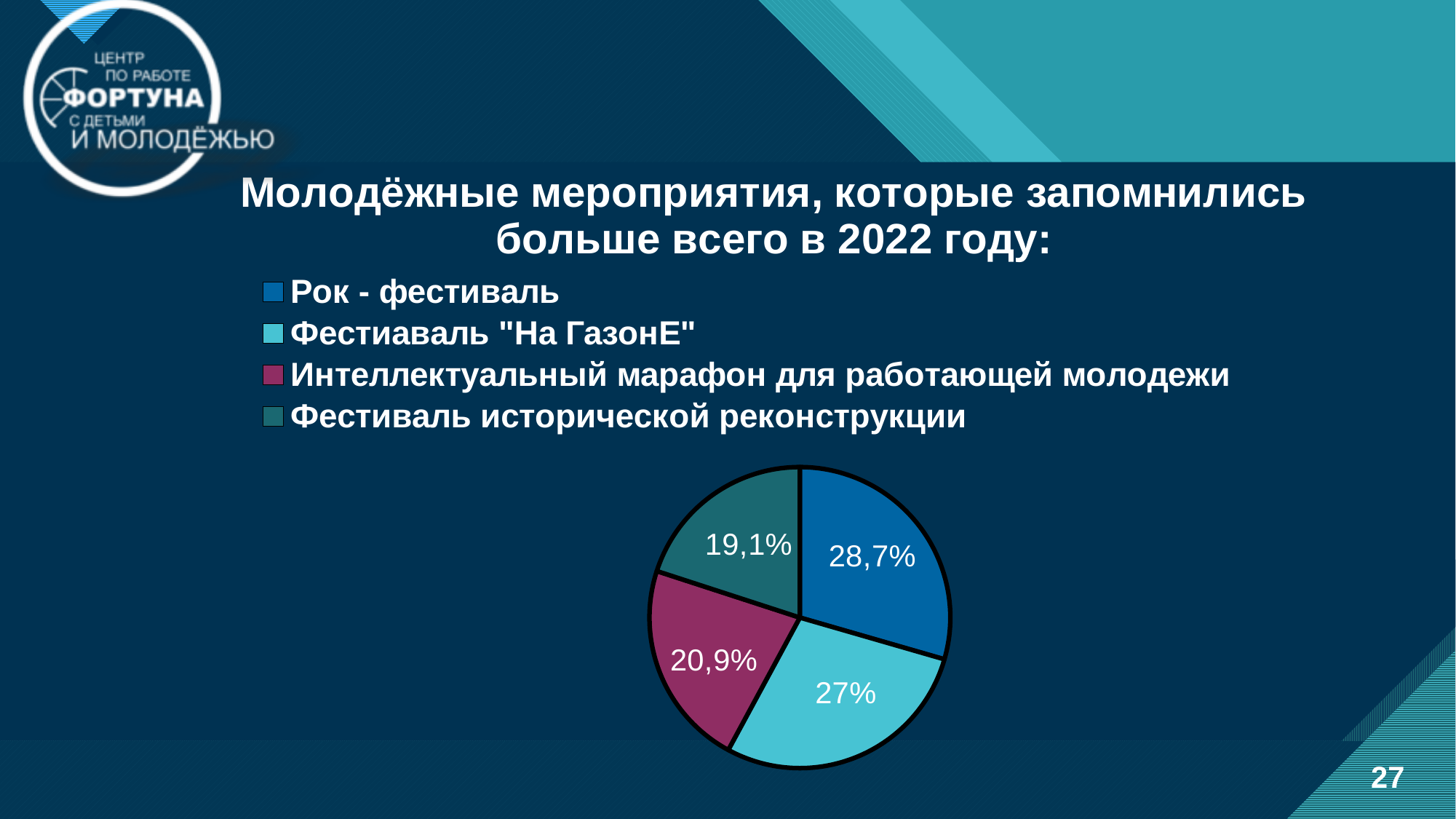
Which category has the largest slice of the pie? Рок - фестиваль How many slices does the pie chart have? 4 What kind of chart is shown on the slide? Pie chart What is the difference in percentage points between Рок - фестиваль and Фестиваль исторической реконструкции? 9,6 What is the title of the chart? Молодёжные мероприятия, которые запомнились больше всего в 2022 году: Which is larger: the slice for Интеллектуальный марафон для работающей молодежи or the slice for Фестиваль исторической реконструкции? Интеллектуальный марафон для работающей молодежи What share of the pie does Фестиаваль "На ГазонЕ" have? 27% What share of the pie does Интеллектуальный марафон для работающей молодежи have? 20,9% What share of the pie does Фестиваль исторической реконструкции have? 19,1% What share of the pie does Рок - фестиваль have? 28,7% What is the difference in percentage points between Фестиаваль "На ГазонЕ" and Интеллектуальный марафон для работающей молодежи? 6,1 Which category has the smallest slice of the pie? Фестиваль исторической реконструкции